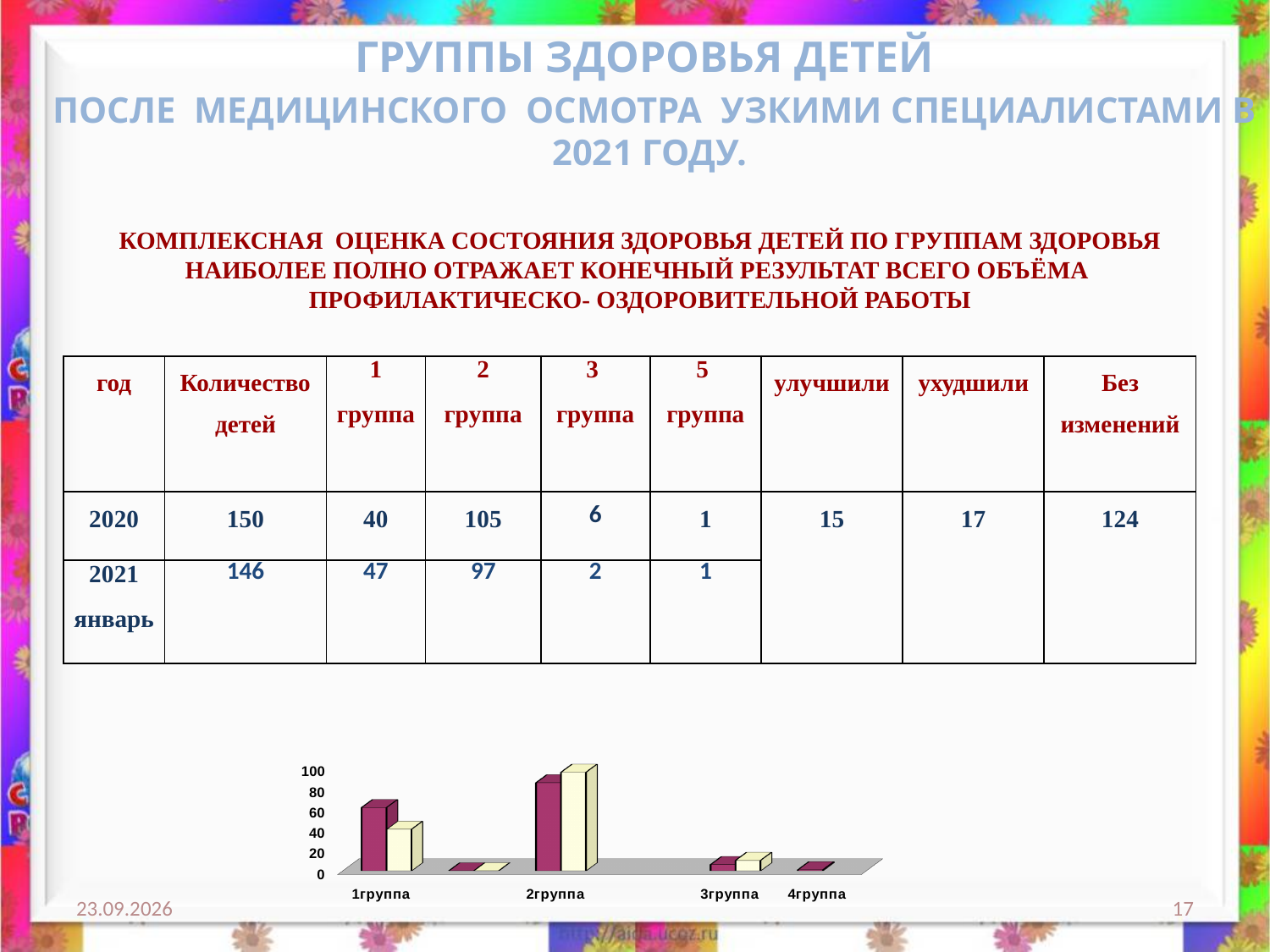
Is the magenta bar for 3группа greater or less than 20? less For 1группа, which bar is taller, the magenta one or the cream one? magenta What kind of chart is shown at the bottom of the slide? bar chart Which category has the tallest bars in the chart? 2группа Is the magenta bar for 1группа greater or less than 40? greater Which is larger, the magenta bar for 1группа or the magenta bar for 2группа? 2группа Do the magenta bars rise or fall going from 2группа to 4группа? fall What is the highest value labelled on the vertical axis of the chart? 100 What is the label of the first category on the horizontal axis of the chart? 1группа Is the cream bar for 2группа greater or less than 80? greater